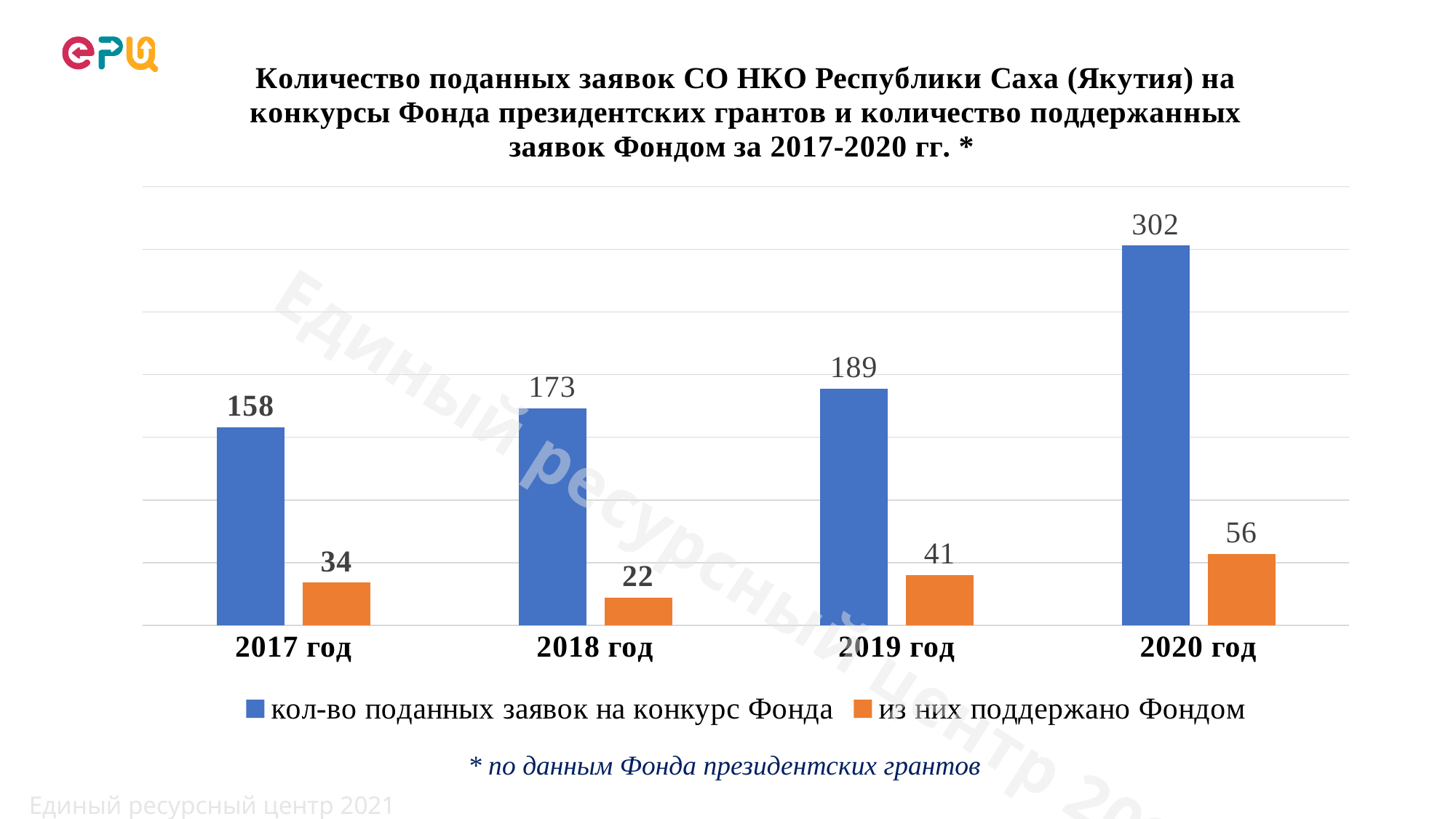
How many years (categories) are shown on the x axis? 4 Which year has the highest number of submitted applications? 2020 год What is the difference between submitted and supported applications in 2017? 124 How many applications were submitted in 2020 (кол-во поданных заявок на конкурс Фонда, 2020 год)? 302 Does the number of submitted applications rise or fall from 2017 to 2020? Rises What is the difference between the number of submitted applications in 2020 and in 2019? 113 How many applications were supported by the Fund in 2019 (из них поддержано Фондом, 2019 год)? 41 How many applications were submitted to the Fund's competition in 2017 (кол-во поданных заявок на конкурс Фонда, 2017 год)? 158 How many series does the legend list? 2 Which is larger: the number of supported applications in 2017 or in 2018? 2017 год What kind of chart is shown on the slide? Bar chart Which year has the lowest number of applications supported by the Fund? 2018 год